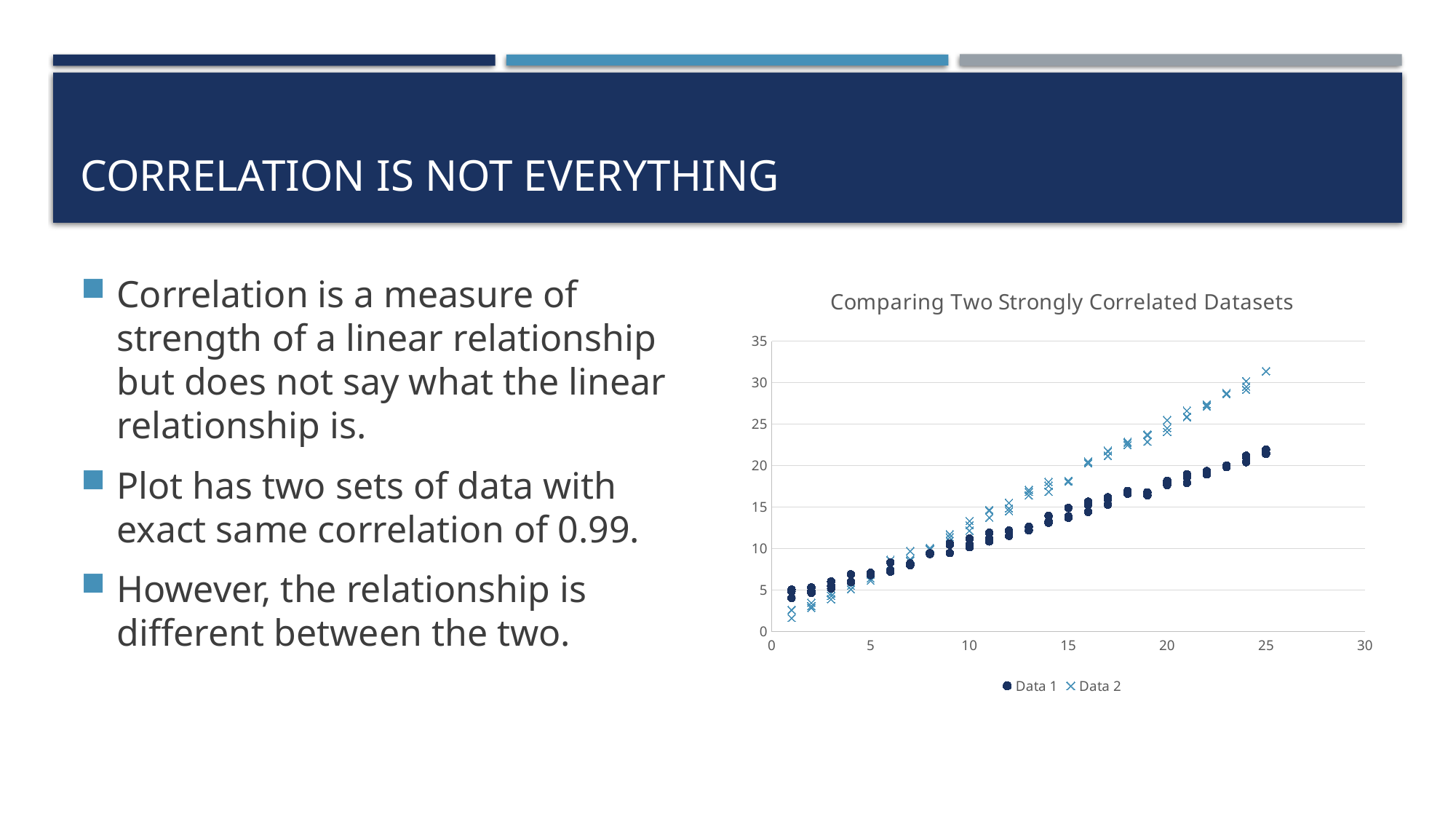
Which series reaches the highest y value on the chart? Data 2 Is the y value for Data 2 at x = 25 greater or less than 25? greater Is the y value for Data 1 at x = 25 greater or less than 25? less At x = 25, which series has the larger y value, Data 1 or Data 2? Data 2 Do the values of Data 2 rise or fall as x increases? rise Is the y value for Data 1 at x = 10 greater or less than 15? less At x = 1, which series has the larger y value, Data 1 or Data 2? Data 1 How many series does the chart's legend list? 2 What is the title of the chart? Comparing Two Strongly Correlated Datasets What are the names of the two series in the chart's legend? Data 1 and Data 2 Do the values of Data 1 rise or fall as x increases? rise What kind of chart is shown on the slide? scatter chart